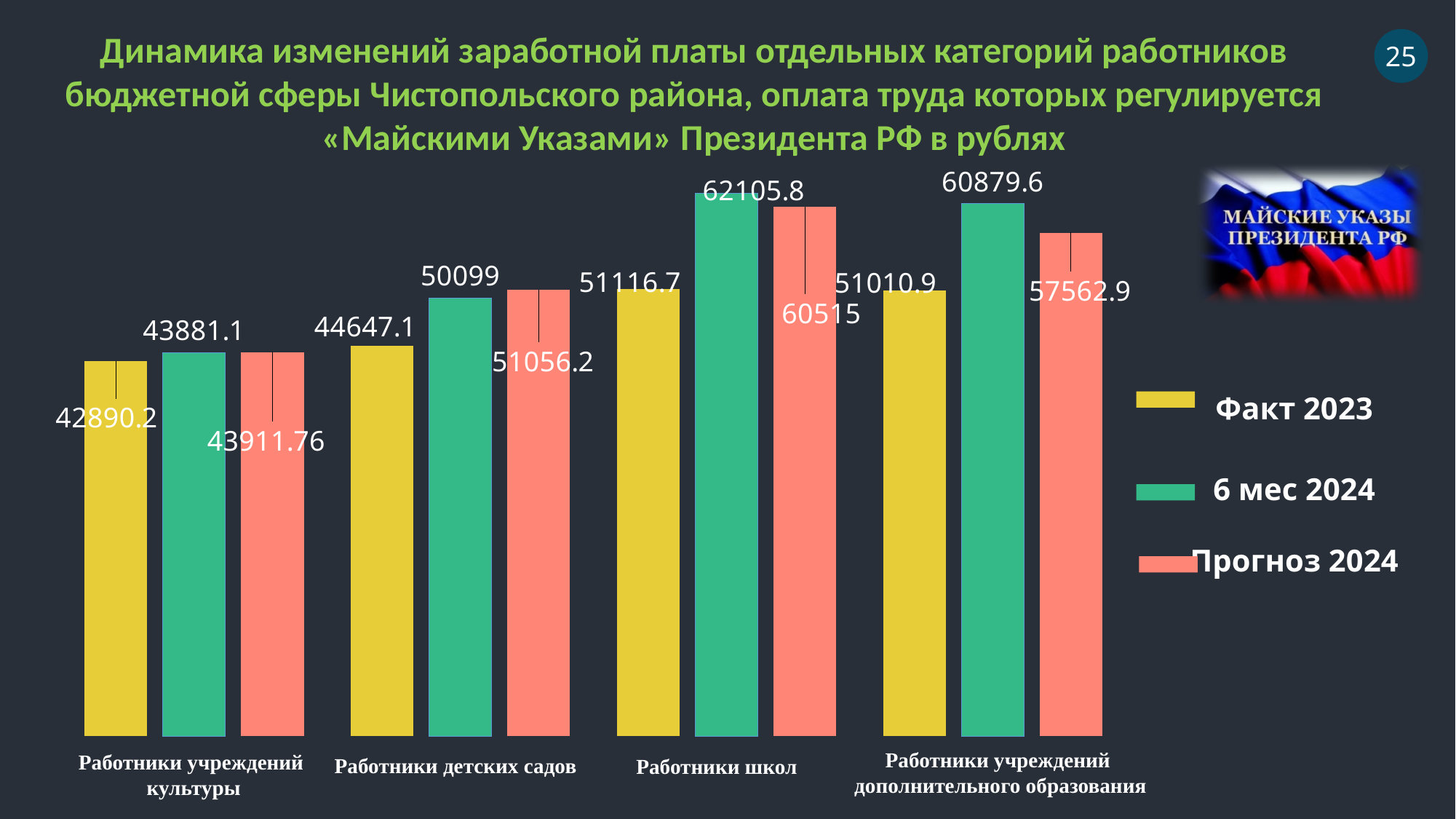
What is the Прогноз 2024 value for Работники учреждений дополнительного образования? 57562.9 How many categories are shown on the x axis? 4 What is the difference between the 6 мес 2024 and Прогноз 2024 values for Работники учреждений дополнительного образования? 3316.7 What is the Факт 2023 value for Работники школ? 51116.7 Which category has the lowest Факт 2023 value? Работники учреждений культуры What is the 6 мес 2024 value for Работники детских садов? 50099 Which category has the highest 6 мес 2024 value? Работники школ How many series does the legend list? 3 What is the difference between the 6 мес 2024 and Факт 2023 values for Работники школ? 10989.1 What is the Прогноз 2024 value for Работники учреждений культуры? 43911.76 For Работники школ, which is larger: the 6 мес 2024 value or the Прогноз 2024 value? 6 мес 2024 What kind of chart is shown on the slide? Bar chart